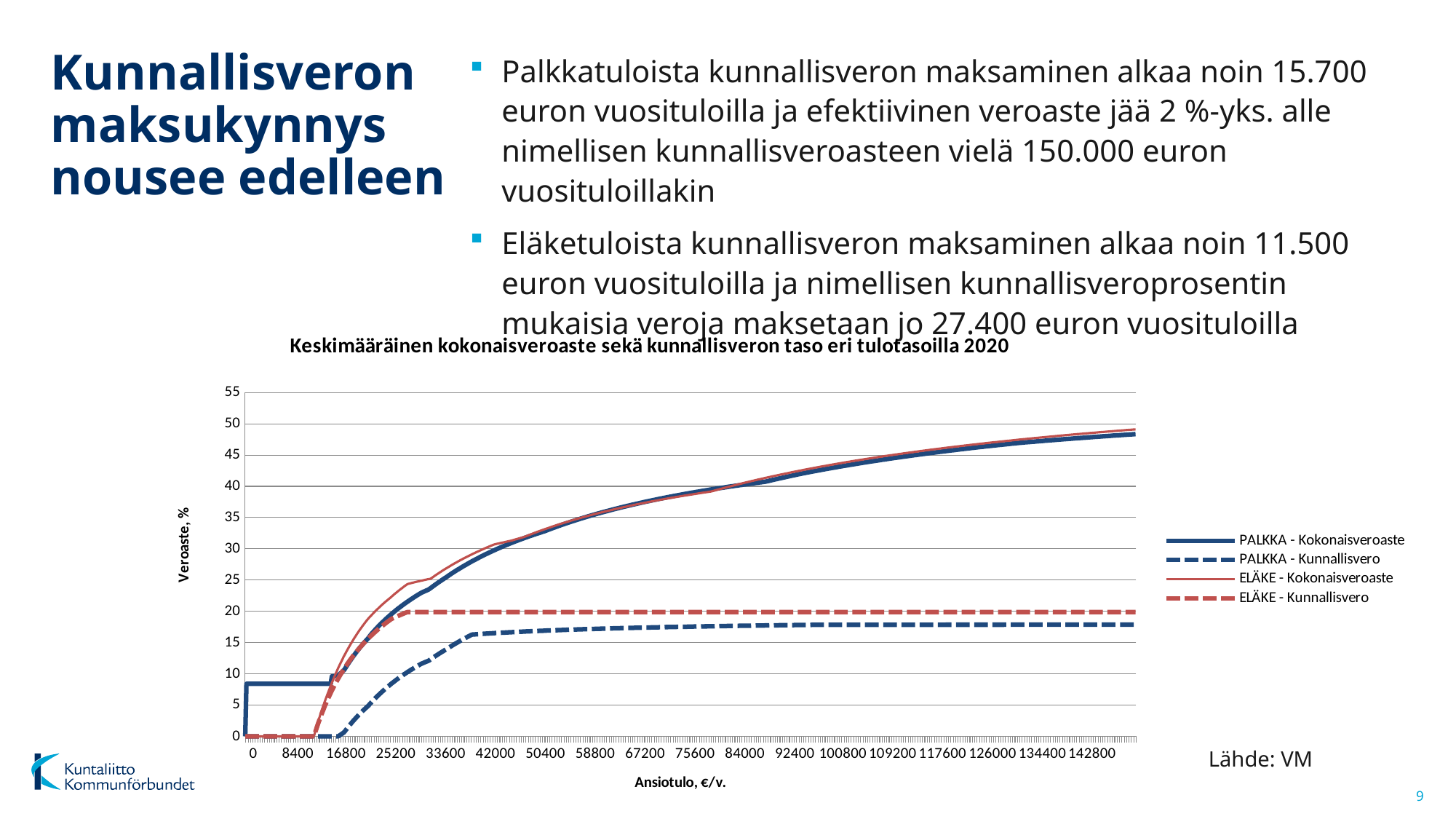
Is the value of ELÄKE - Kokonaisveroaste at 33600 greater or less than 20? greater How many series does the chart legend list? 4 Does the PALKKA - Kokonaisveroaste line rise or fall as Ansiotulo increases from 16800 to 142800? rise What kind of chart is shown on the slide? line chart What is the label of the vertical axis of the chart? Veroaste, % Is the value of PALKKA - Kokonaisveroaste at 142800 greater or less than 45? greater Is the value of PALKKA - Kunnallisvero at 142800 greater or less than 20? less What is the title of the chart? Keskimääräinen kokonaisveroaste sekä kunnallisveron taso eri tulotasoilla 2020 At an Ansiotulo of 142800, which is larger: ELÄKE - Kunnallisvero or PALKKA - Kunnallisvero? ELÄKE - Kunnallisvero At an Ansiotulo of 25200, which is larger: ELÄKE - Kunnallisvero or PALKKA - Kunnallisvero? ELÄKE - Kunnallisvero